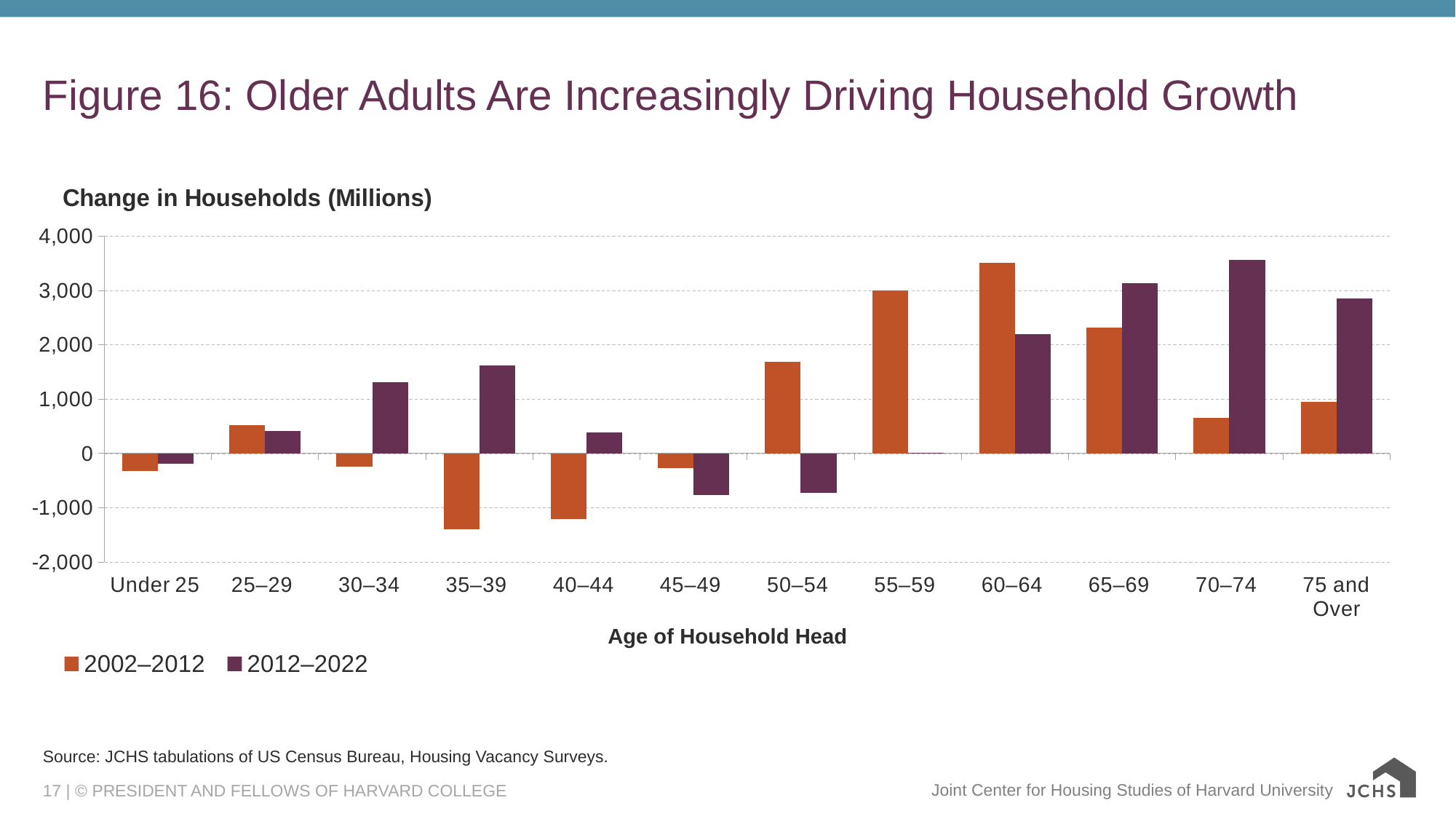
Is the 2002–2012 value for the 35–39 age group greater or less than -1,000? less Which age group has the highest value for the 2012–2022 series? 70–74 Which age group has the lowest value for the 2002–2012 series? 35–39 For the 65–69 age group, which series has the larger value, 2002–2012 or 2012–2022? 2012–2022 Is the 2012–2022 value for the 70–74 age group greater or less than 3,000? greater For the 55–59 age group, which series has the larger value, 2002–2012 or 2012–2022? 2002–2012 Is the 2012–2022 value for the 30–34 age group greater or less than 1,000? greater Which age group has the highest value for the 2002–2012 series? 60–64 What kind of chart is shown on the slide? bar chart How many age groups are shown on the x axis? 12 How many series does the legend list? 2